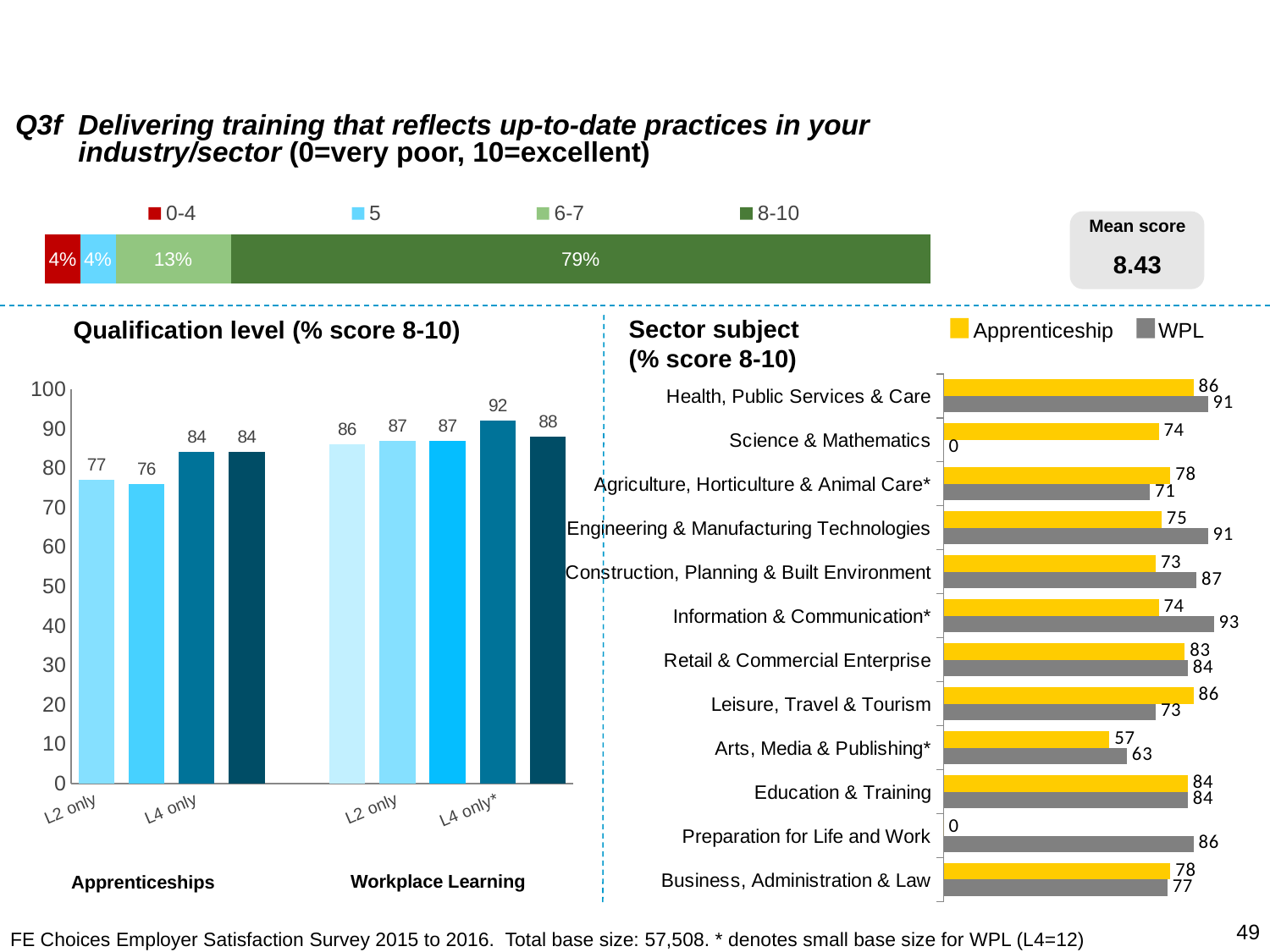
In the Qualification level chart, what is the highest value shown in the Workplace Learning group? 92 In the stacked bar at the top of the slide, what percentage scored 8-10? 79% In the Qualification level chart, what is the value for L2 only under Apprenticeships? 77 In the Sector subject chart, what is the WPL value for Information & Communication*? 93 How many sector subjects are shown in the Sector subject chart? 12 What is the mean score shown on the slide? 8.43 In the Sector subject chart, which sector has the highest WPL value? Information & Communication* How many series does the legend of the Sector subject chart list? 2 What kind of chart is the Sector subject chart? Bar chart In the Sector subject chart, what is the Apprenticeship value for Health, Public Services & Care? 86 In the Sector subject chart, what is the difference between the WPL and Apprenticeship values for Engineering & Manufacturing Technologies? 16 In the Sector subject chart, which is larger for Leisure, Travel & Tourism: the Apprenticeship value or the WPL value? Apprenticeship